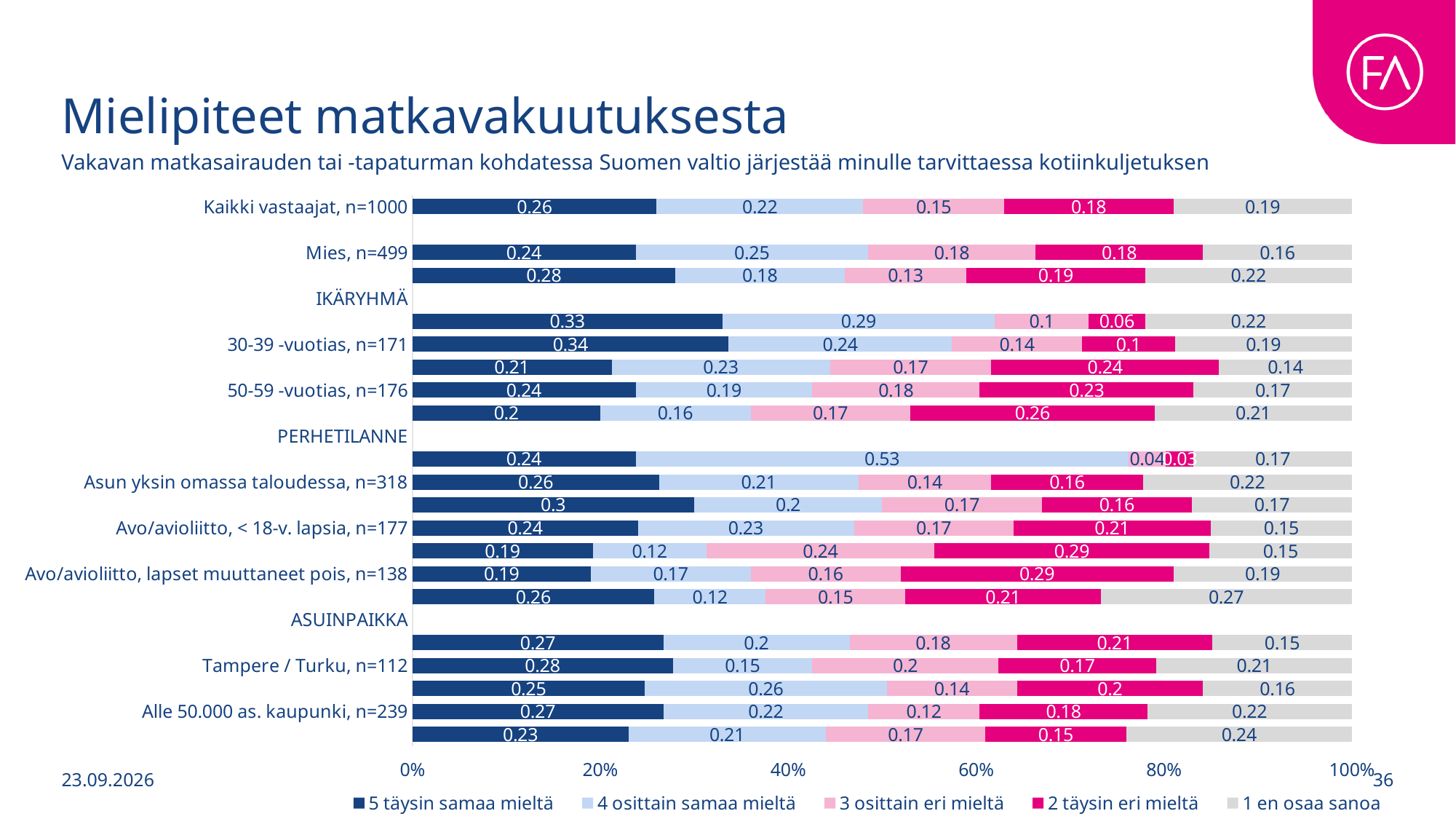
Which is larger: the '2 täysin eri mieltä' value for 'Avo/avioliitto, < 18-v. lapsia, n=177' or for 'Alle 50.000 as. kaupunki, n=239'? Avo/avioliitto, < 18-v. lapsia, n=177 What is the value of '2 täysin eri mieltä' for '30-39 -vuotias, n=171'? 0.1 What kind of chart is shown on the slide? stacked bar chart What is the value of '3 osittain eri mieltä' for 'Asun yksin omassa taloudessa, n=318'? 0.14 What is the value of '2 täysin eri mieltä' for 'Avo/avioliitto, lapset muuttaneet pois, n=138'? 0.29 What is the difference between the '5 täysin samaa mieltä' values for '30-39 -vuotias, n=171' and '50-59 -vuotias, n=176'? 0.1 What is the value of '4 osittain samaa mieltä' for '50-59 -vuotias, n=176'? 0.19 What is the value of '1 en osaa sanoa' for 'Tampere / Turku, n=112'? 0.21 What is the value of '1 en osaa sanoa' for 'Mies, n=499'? 0.16 Which legend entry is shown in the darkest blue colour? 5 täysin samaa mieltä How many series does the legend list? 5 What is the value of '5 täysin samaa mieltä' for 'Kaikki vastaajat, n=1000'? 0.26